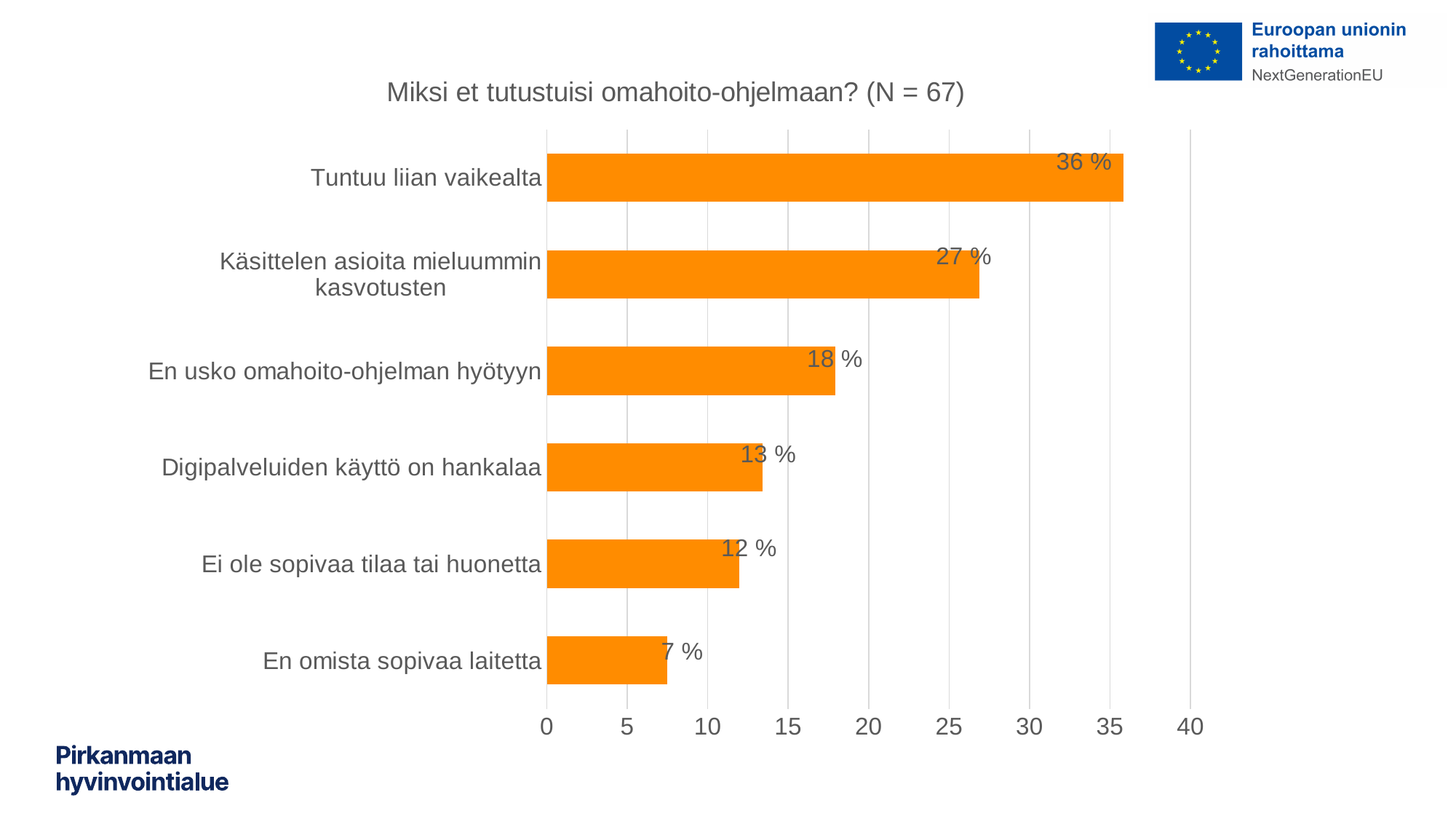
What is the highest value shown on the horizontal axis? 40 Which is larger: the value for "Digipalveluiden käyttö on hankalaa" or "Ei ole sopivaa tilaa tai huonetta"? Digipalveluiden käyttö on hankalaa What kind of chart is shown on the slide? bar chart What is the value for "Tuntuu liian vaikealta"? 36 % What is the difference between the values for "Tuntuu liian vaikealta" and "Käsittelen asioita mieluummin kasvotusten"? 9 % What is the value for "En usko omahoito-ohjelman hyötyyn"? 18 % What is the value for "En omista sopivaa laitetta"? 7 % Which category has the lowest value? En omista sopivaa laitetta What is the title of the chart? Miksi et tutustuisi omahoito-ohjelmaan? (N = 67) How many categories are shown in the chart? 6 Is the value for "Käsittelen asioita mieluummin kasvotusten" greater or less than 25? greater Which category has the highest value? Tuntuu liian vaikealta